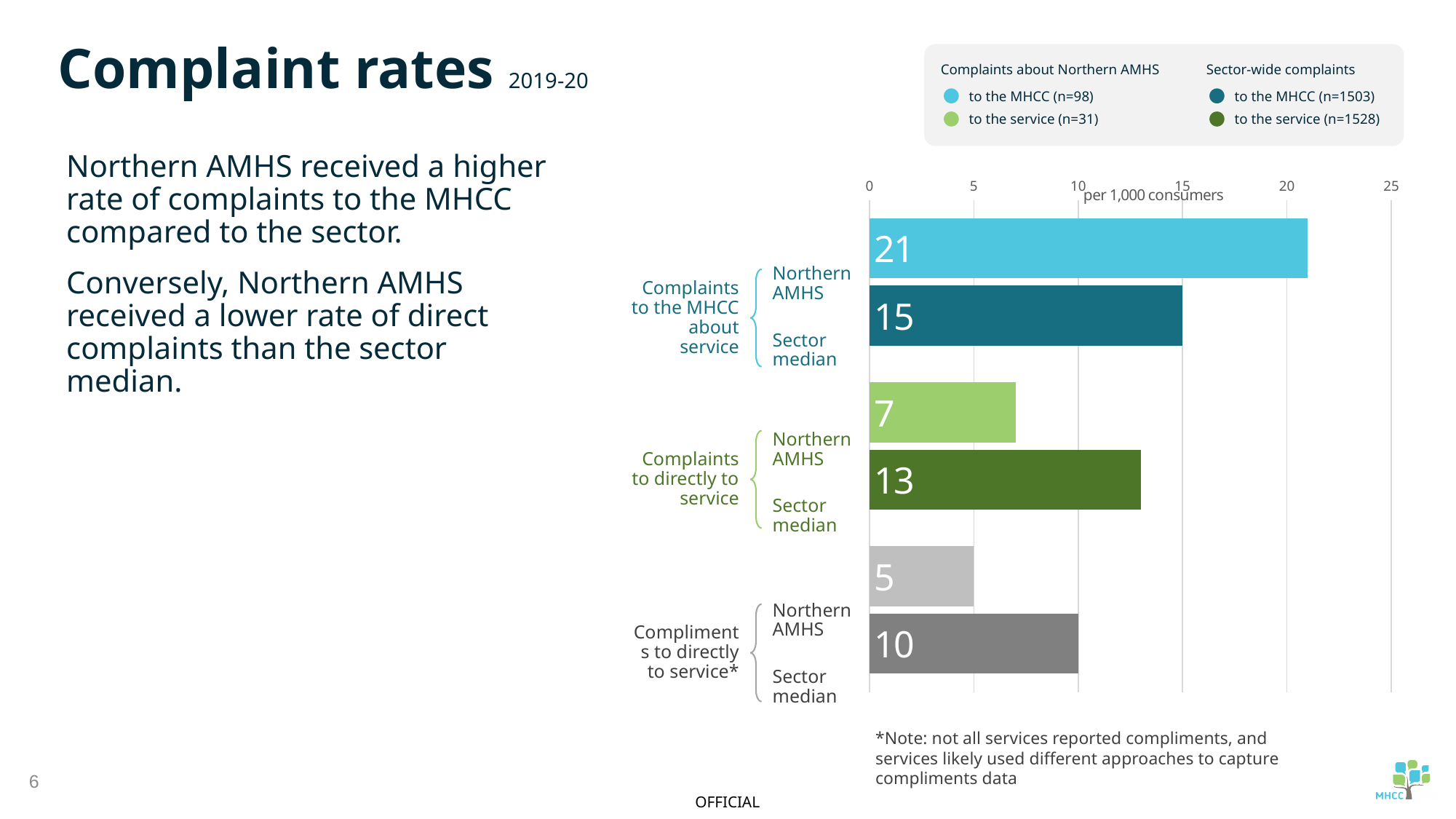
What kind of chart is shown on the slide? Bar chart Which bar has the lowest value on the chart? Northern AMHS, compliments directly to service What is the difference between the sector median and Northern AMHS rates of complaints directly to service? 6 What is the rate of complaints to the MHCC about service for Northern AMHS? 21 What is the rate of complaints directly to service for Northern AMHS? 7 What unit is the horizontal axis of the chart measured in? per 1,000 consumers What is the sector median rate of compliments directly to service? 10 What is the difference between the Northern AMHS and sector median rates of complaints to the MHCC about service? 6 How many bars are plotted on the chart? 6 Which bar has the highest value on the chart? Northern AMHS, complaints to the MHCC about service Which is larger: the Northern AMHS rate of complaints directly to service or the sector median rate of complaints directly to service? Sector median What is the sector median rate of complaints to the MHCC about service? 15